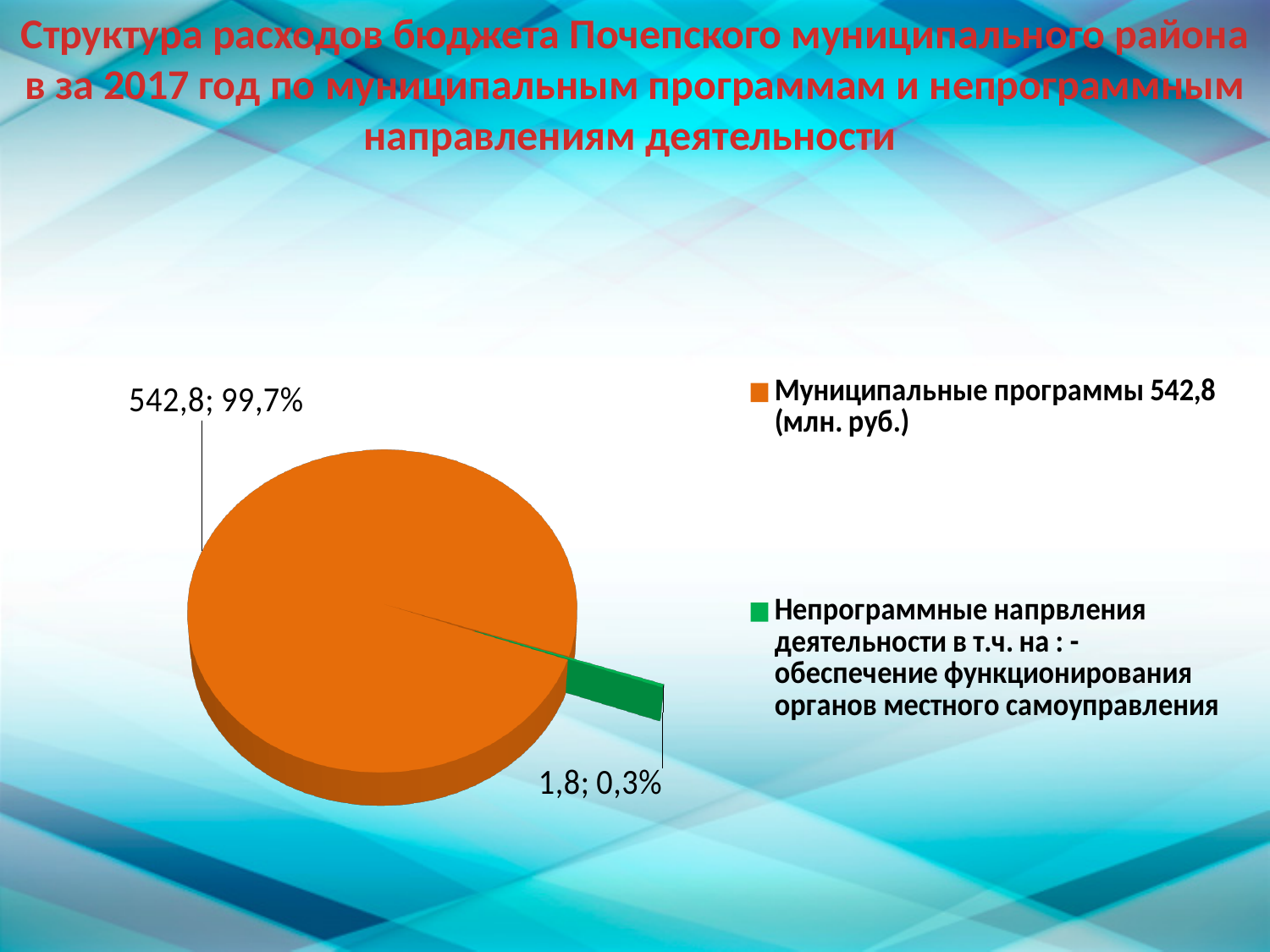
What value is shown for the slice 'Непрограммные напрвления деятельности'? 1,8 How many entries does the legend list? 2 How many slices does the pie chart have? 2 Which slice is the smallest? Непрограммные напрвления деятельности What value is shown for the slice 'Муниципальные программы'? 542,8 Which slice is the largest? Муниципальные программы What share of the pie does 'Непрограммные напрвления деятельности' represent? 0,3% What colour is the slice for 'Непрограммные напрвления деятельности'? green What kind of chart is shown on the slide? pie chart What is the difference between the values for 'Муниципальные программы' and 'Непрограммные напрвления деятельности'? 541,0 What share of the pie does 'Муниципальные программы' represent? 99,7% Which is larger: 'Муниципальные программы' or 'Непрограммные напрвления деятельности'? Муниципальные программы